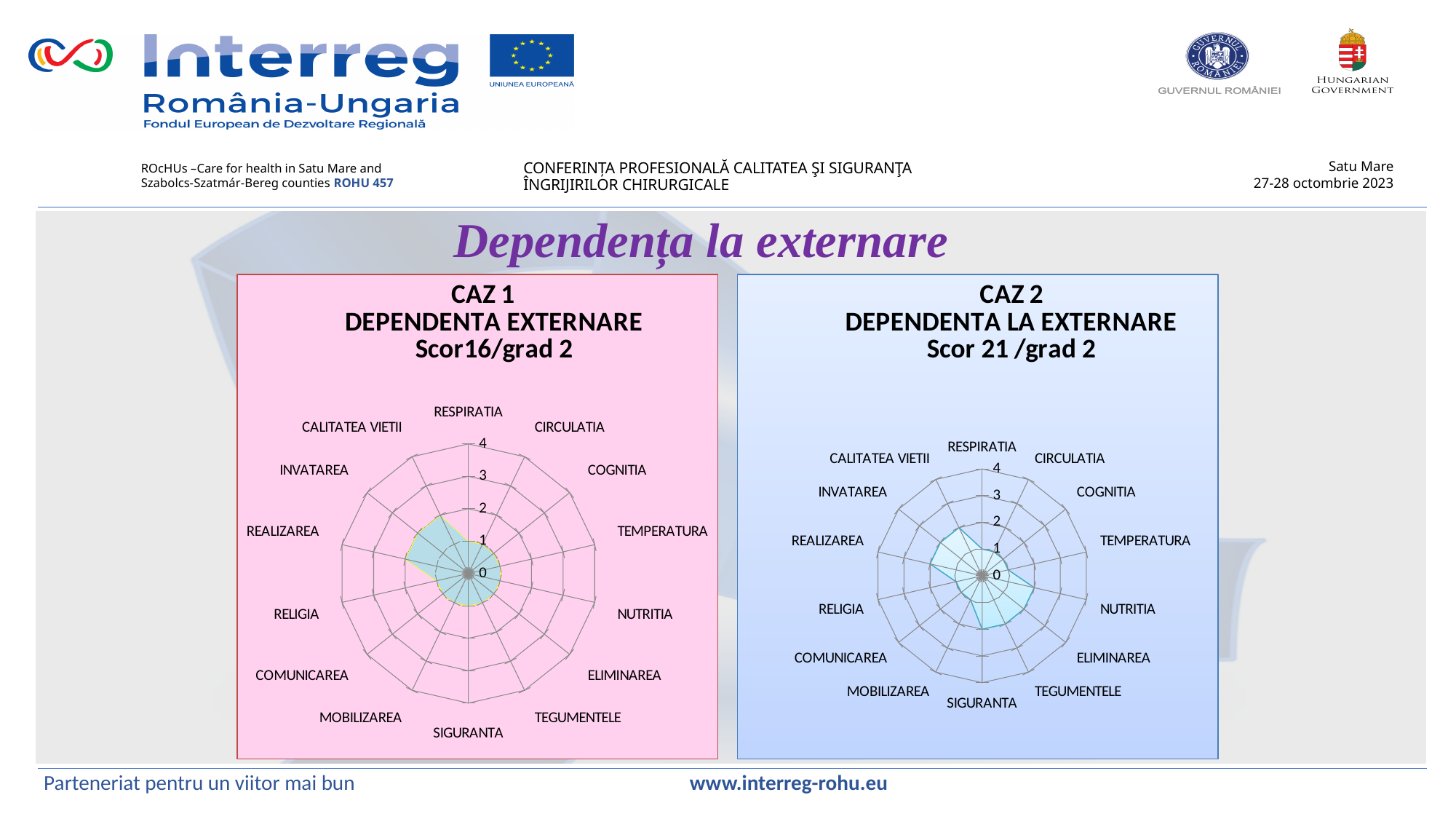
On the CAZ 2 chart, is the value for REALIZAREA greater or less than 3? less What kind of chart is used in the CAZ 1 panel? Radar chart On the CAZ 1 chart, which is larger, the value for CALITATEA VIETII or the value for TEMPERATURA? CALITATEA VIETII How many categories are plotted on the CAZ 2 radar chart? 14 What is the maximum value shown on the radial axis of the CAZ 1 chart? 4 On the CAZ 2 chart, which is larger, the value for NUTRITIA or the value for CIRCULATIA? NUTRITIA On the CAZ 1 chart, is the value for CALITATEA VIETII greater or less than 3? less On the CAZ 1 chart, is the value for TEMPERATURA greater or less than 2? less What score and grade are given in the title of the CAZ 2 chart? Scor 21 /grad 2 How many categories are plotted on the CAZ 1 radar chart? 14